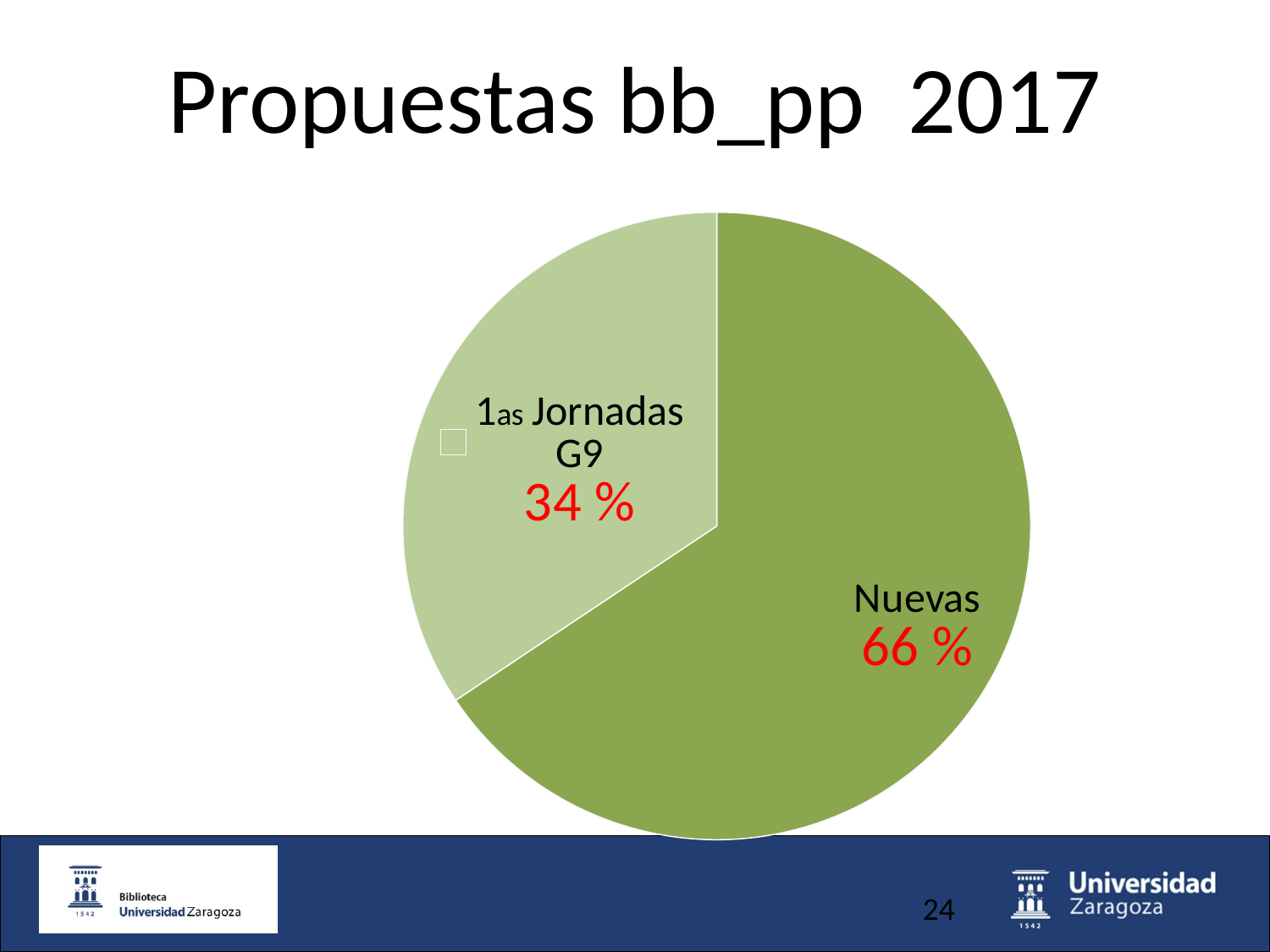
Which is larger, the "Nuevas" slice or the "1as Jornadas G9" slice? Nuevas Which slice of the pie is the smallest? 1as Jornadas G9 Which slice of the pie is shown in the lighter green colour? 1as Jornadas G9 What is the difference in percentage points between the "Nuevas" slice and the "1as Jornadas G9" slice? 32 What is the title of the slide containing the pie chart? Propuestas bb_pp 2017 Which slice of the pie is the largest? Nuevas Is the share for "Nuevas" greater or less than 50 %? greater How many slices does the pie chart have? 2 What share of the pie does the "Nuevas" slice represent? 66 % What share of the pie does the "1as Jornadas G9" slice represent? 34 % What kind of chart is shown on the slide? pie chart